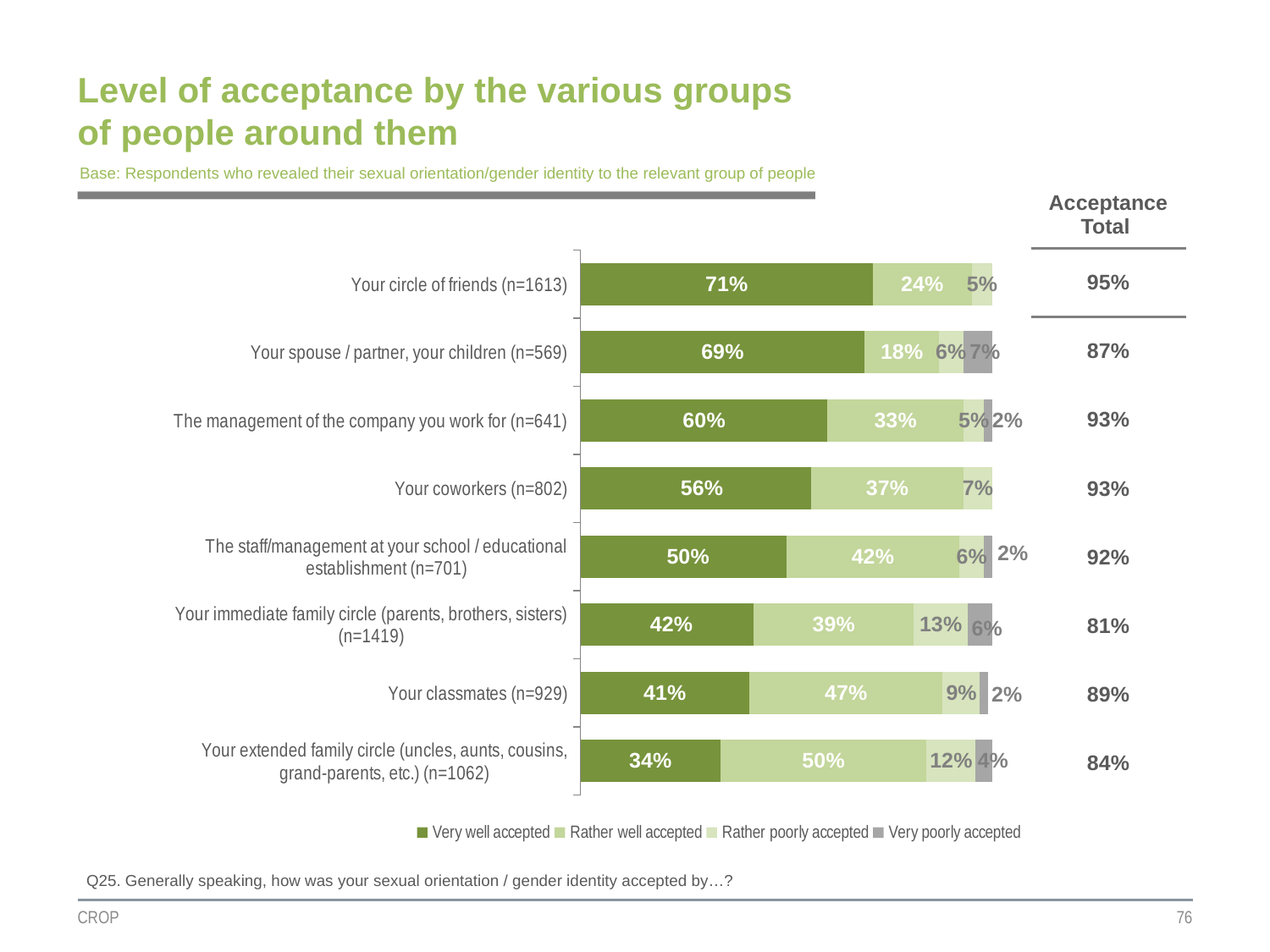
What kind of chart is shown on the slide? Stacked bar chart What percentage of respondents said their sexual orientation / gender identity was "Very well accepted" by their circle of friends? 71% What is the combined total of "Very well accepted" and "Rather well accepted" for "Your coworkers (n=802)"? 93% Which group has the lowest "Very well accepted" percentage? Your extended family circle (uncles, aunts, cousins, grand-parents, etc.) (n=1062) Which group has the highest "Very well accepted" percentage? Your circle of friends (n=1613) What is the difference between the "Very well accepted" values for "Your circle of friends" and "Your spouse / partner, your children"? 2 percentage points Which has a larger "Rather well accepted" value: "Your coworkers (n=802)" or "The management of the company you work for (n=641)"? Your coworkers (n=802) What is the Acceptance Total shown for "Your immediate family circle (parents, brothers, sisters) (n=1419)"? 81% How many groups of people are listed as categories in the chart? 8 What is the "Rather well accepted" value for "Your classmates (n=929)"? 47% How many series does the legend list? 4 What is the "Rather poorly accepted" value for "Your immediate family circle (parents, brothers, sisters) (n=1419)"? 13%